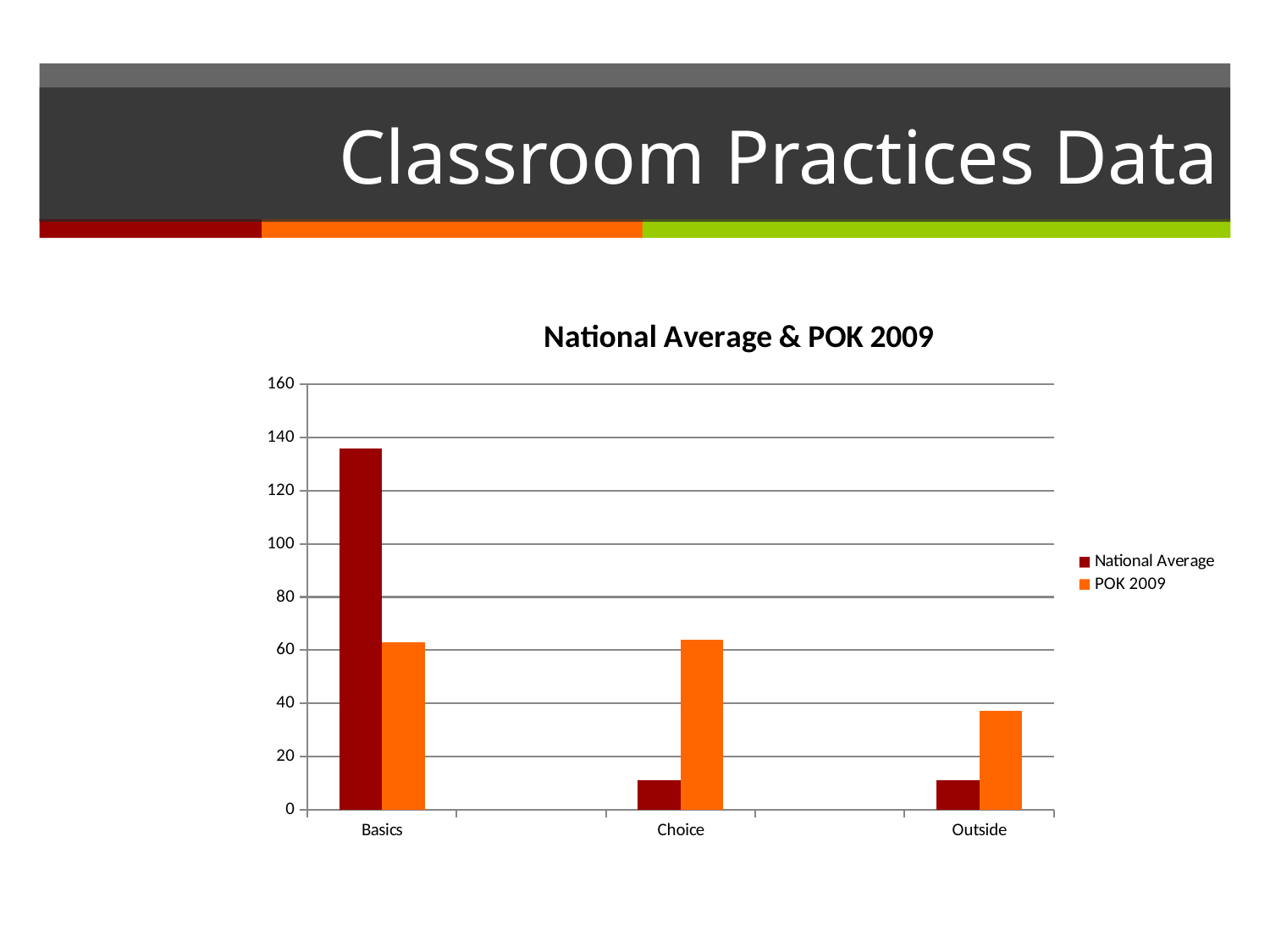
Which category has the lowest POK 2009 value? Outside Is the POK 2009 value for Choice greater or less than 40? greater For Basics, which is larger: National Average or POK 2009? National Average What kind of chart is shown on the slide? bar chart Is the POK 2009 value for Basics greater or less than 80? less Is the National Average value for Basics greater or less than 120? greater For Outside, which is larger: National Average or POK 2009? POK 2009 How many series does the legend list? 2 Which category has the highest National Average value? Basics What is the title of the chart? National Average & POK 2009 How many categories are shown on the x axis? 3